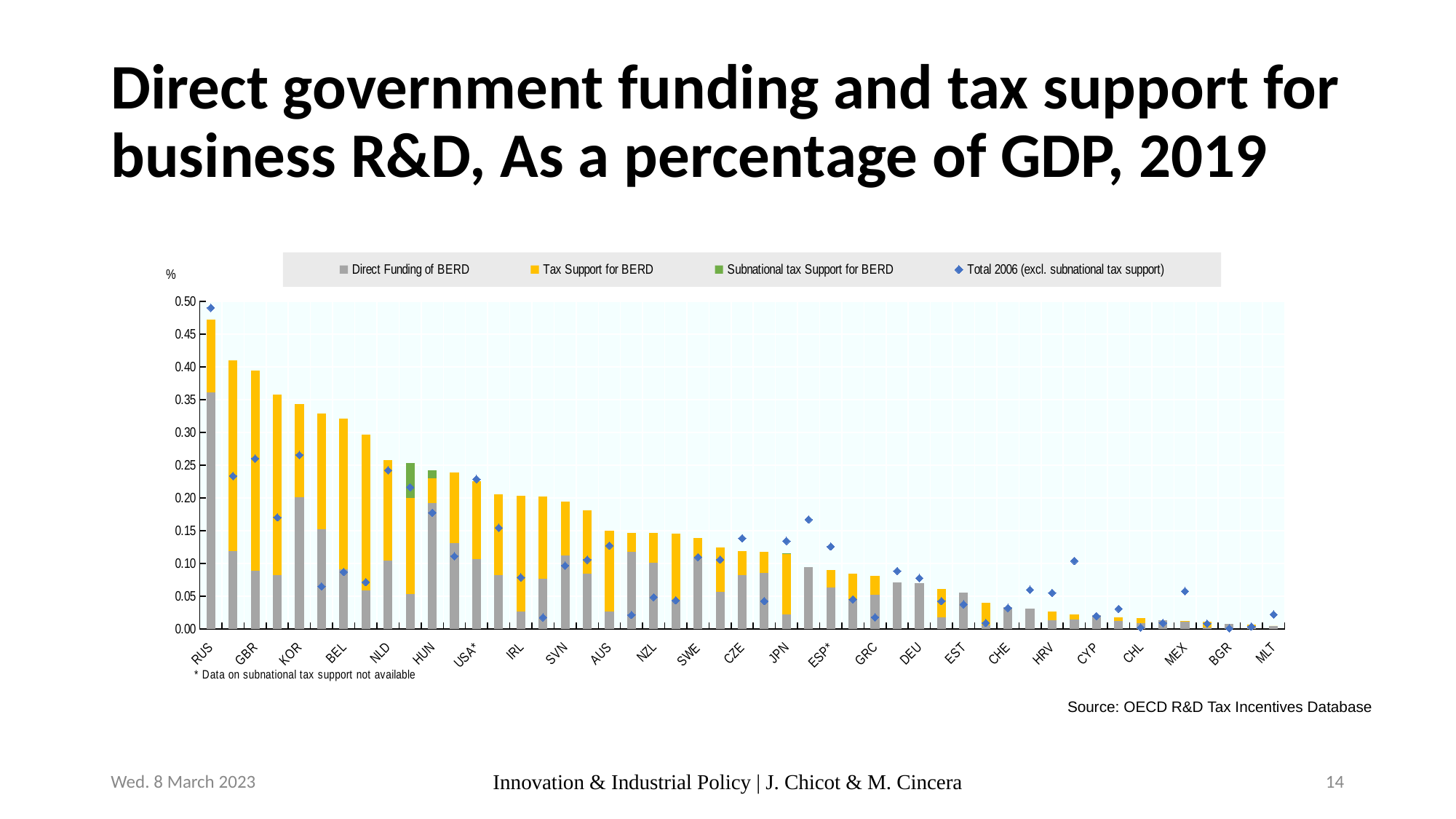
Is the total bar for BEL greater or less than 0.30? greater What kind of chart is shown on the slide? Stacked bar chart Which has the larger total bar, RUS or GBR? RUS Which country has the highest total bar in the chart? RUS Which series is shown in yellow in the legend? Tax Support for BERD Do the total bar values rise or fall moving from left to right along the x axis? fall Is the total bar for RUS greater or less than 0.45? greater How many series does the legend list? 4 Which has the larger Direct Funding of BERD value, RUS or KOR? RUS Is the total bar for MLT greater or less than 0.05? less